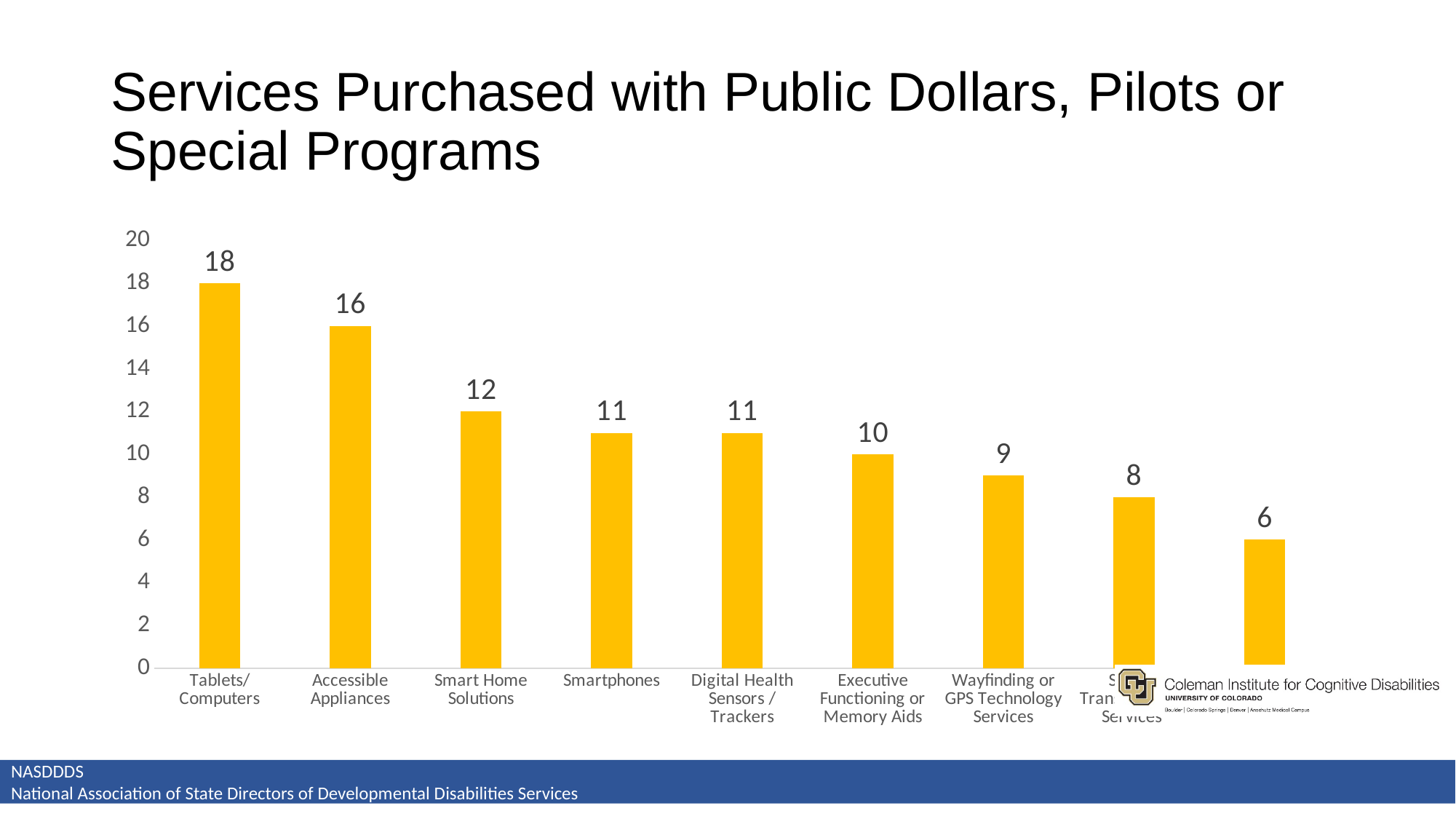
Which category has the highest value? Tablets/Computers What is the value for Wayfinding or GPS Technology Services? 9 What is the lowest value shown on the chart? 6 What is the value for Tablets/Computers? 18 What type of chart is shown on the slide? bar chart What is the value for Smart Home Solutions? 12 How many bars are shown on the chart? 9 What is the value for Accessible Appliances? 16 What is the difference between the values for Tablets/Computers and Accessible Appliances? 2 What is the title of the chart on the slide? Services Purchased with Public Dollars, Pilots or Special Programs What is the value for Executive Functioning or Memory Aids? 10 Which is larger, the value for Smart Home Solutions or the value for Smartphones? Smart Home Solutions